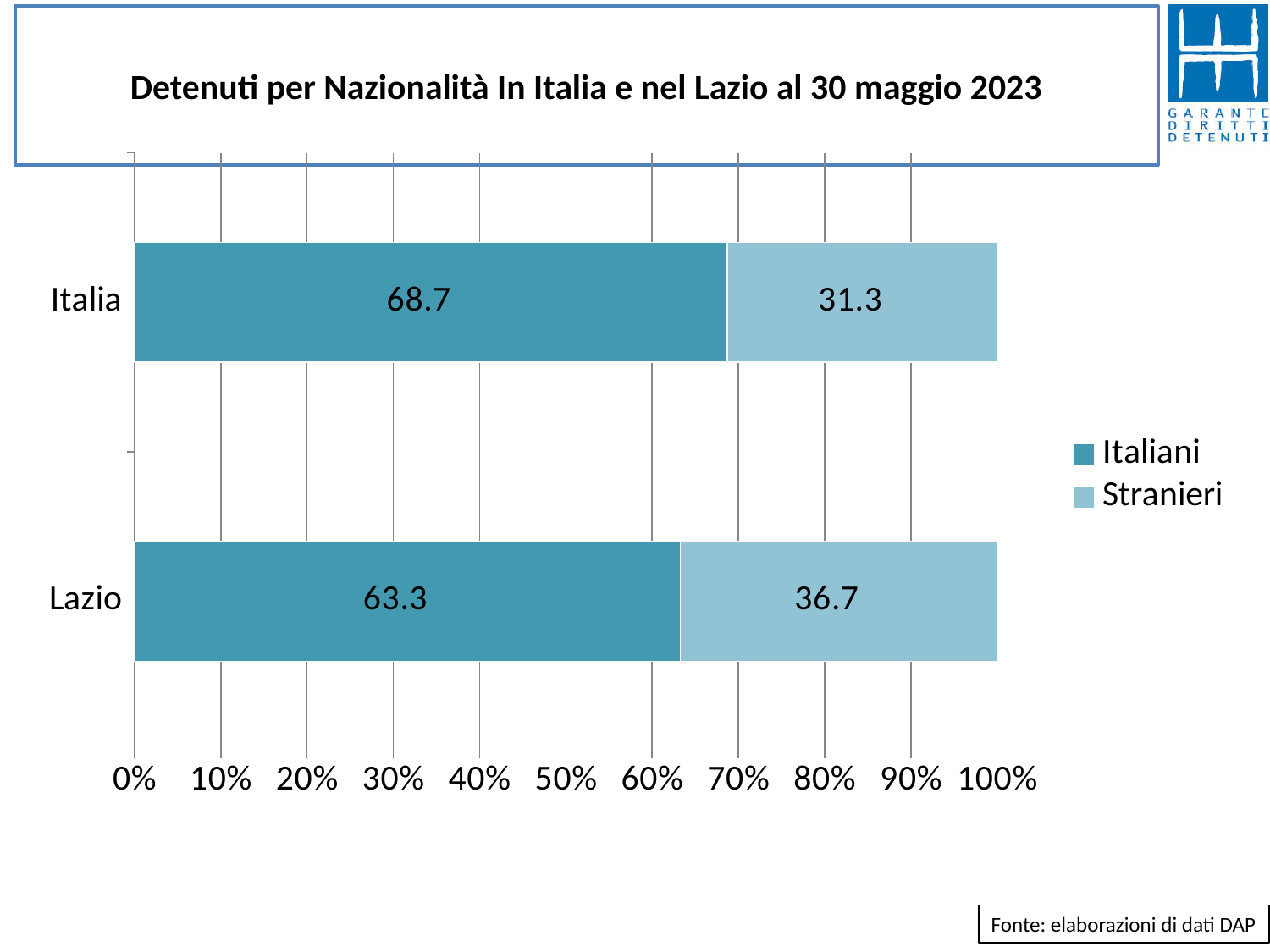
What is the difference between the Stranieri values for Lazio and Italia? 5.4 How many categories are shown on the chart? 2 Which category has the higher Italiani value, Italia or Lazio? Italia Which category has the higher Stranieri value, Italia or Lazio? Lazio What is the value for Stranieri in Italia? 31.3 What is the title of the chart? Detenuti per Nazionalità In Italia e nel Lazio al 30 maggio 2023 What is the value for Italiani in Lazio? 63.3 How many series does the legend list? 2 What is the difference between the Italiani values for Italia and Lazio? 5.4 What is the value for Stranieri in Lazio? 36.7 What is the value for Italiani in Italia? 68.7 What kind of chart is shown on the slide? Stacked bar chart